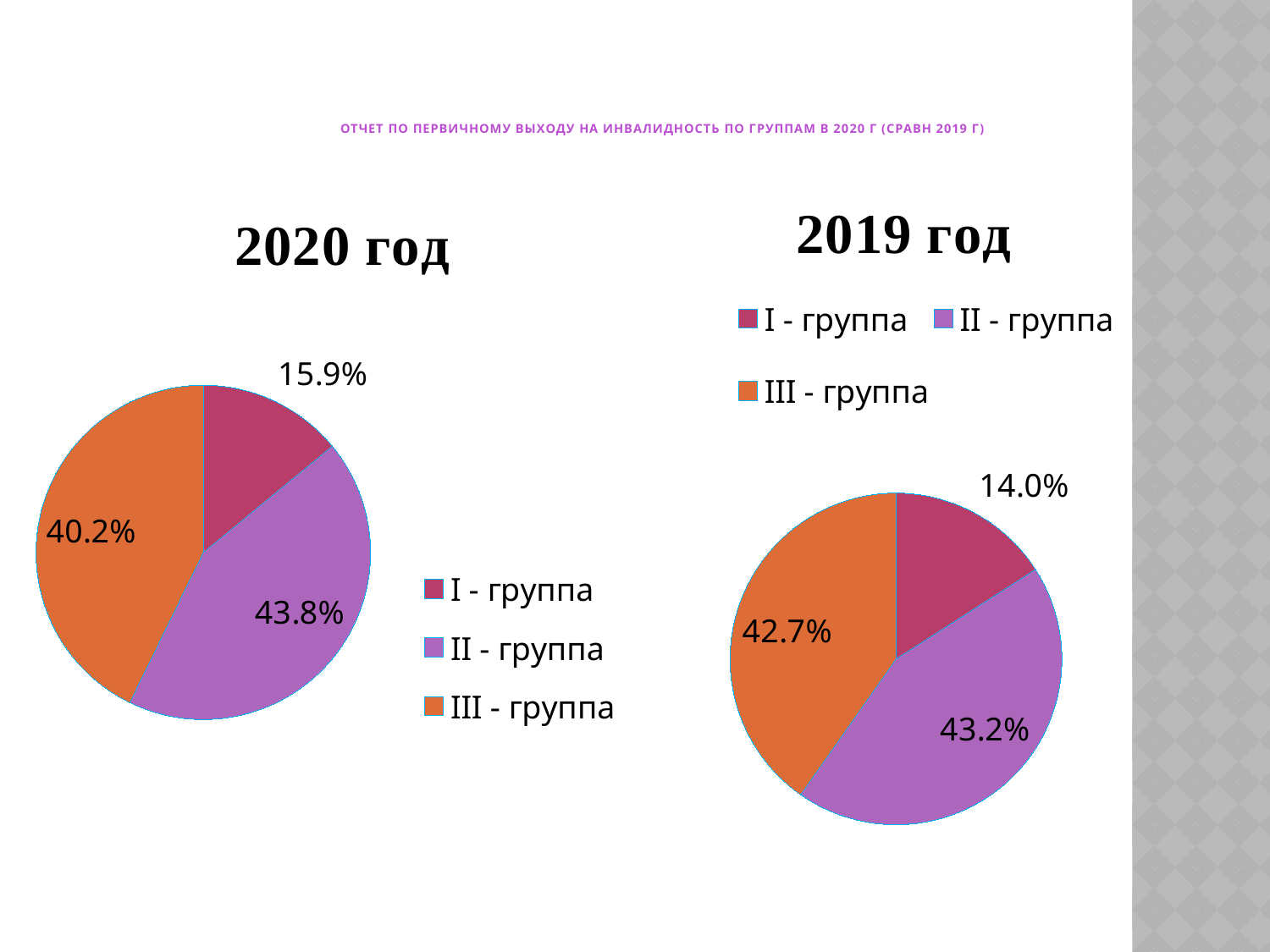
In the "2020 год" pie chart, what is the difference between the shares of II - группа and III - группа? 3.6% In the "2019 год" pie chart, is the share for I - группа larger or smaller than the share for III - группа? smaller How many entries does the legend of the "2019 год" chart list? 3 In the "2019 год" pie chart, what is the share for I - группа? 14.0% In the "2020 год" pie chart, what is the share for I - группа? 15.9% In the "2020 год" pie chart, which group has the largest share? II - группа What type of chart is used for the "2020 год" data? Pie chart In the "2019 год" pie chart, what is the share for II - группа? 43.2% In the "2020 год" pie chart, what is the share for II - группа? 43.8% In the "2019 год" pie chart, which group has the smallest share? I - группа In the "2020 год" pie chart, what is the share for III - группа? 40.2% In the "2019 год" pie chart, what is the share for III - группа? 42.7%